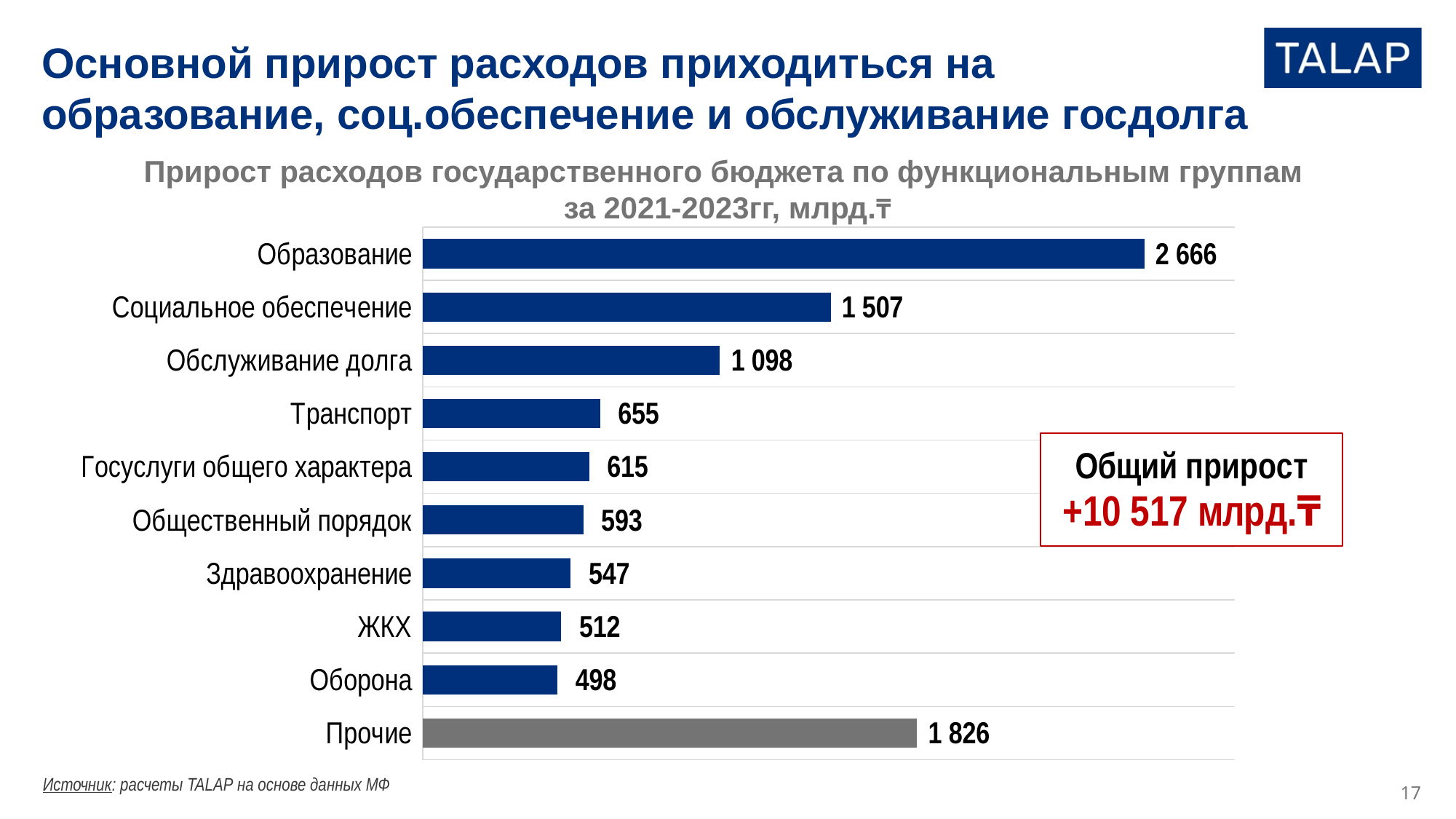
Which category has the highest value? Образование Which category's bar is coloured grey instead of dark blue? Прочие What is the value for Образование? 2 666 What is the value for Прочие? 1 826 What is the value for Обслуживание долга? 1 098 Which is larger, the value for Здравоохранение or the value for ЖКХ? Здравоохранение Which category has the lowest value? Оборона What kind of chart is shown on the slide? Bar chart What is the value for Оборона? 498 How many categories are shown in the chart? 10 What is the difference between the values for Образование and Социальное обеспечение? 1 159 What is the difference between the values for Транспорт and Госуслуги общего характера? 40